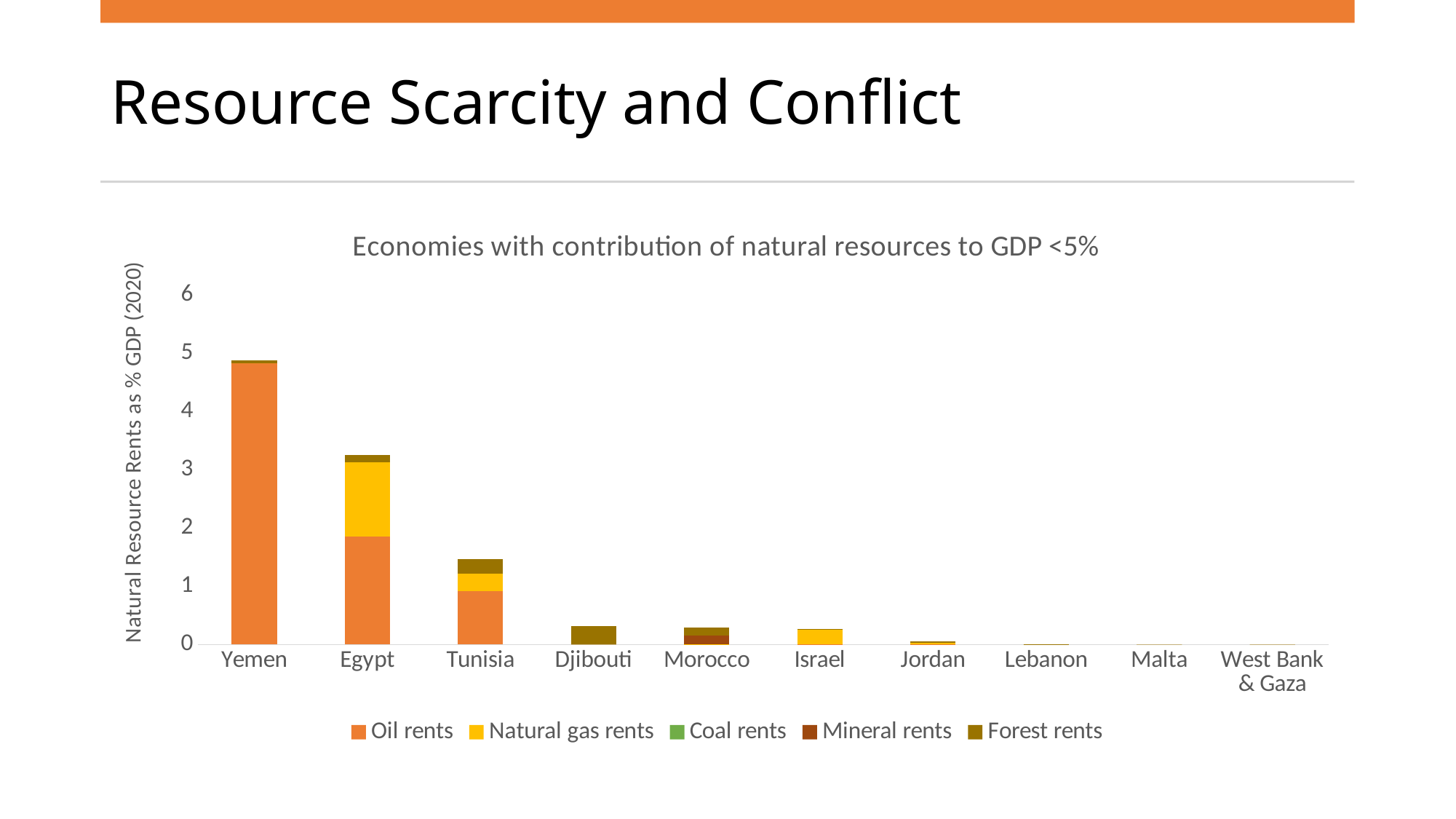
What kind of chart is shown on the slide? Stacked bar chart Is the total value for Egypt greater or less than 3? greater Which economy has the highest total natural resource rents as % of GDP? Yemen Is the total value for Yemen greater or less than 4? greater Is the total value for Tunisia greater or less than 2? less What is the title of the chart? Economies with contribution of natural resources to GDP <5% How many series does the legend list? 5 Which has a larger total bar, Egypt or Tunisia? Egypt Do the total bar values rise or fall moving from left to right along the x axis? Fall How many economies are shown on the x axis? 10